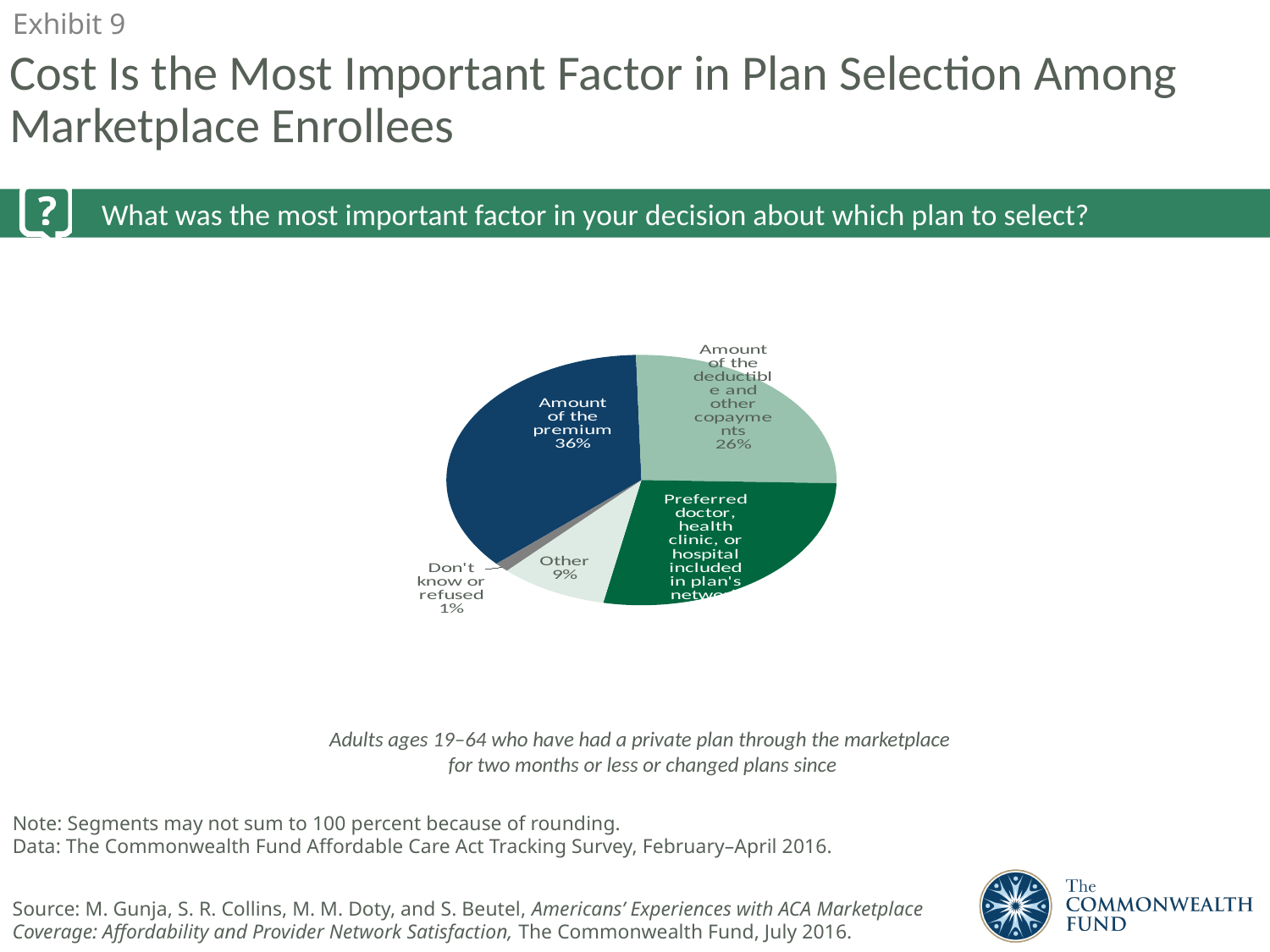
How many percentage points larger is the "Amount of the premium" slice than the "Amount of the deductible and other copayments" slice? 10 How many slices does the pie chart have? 5 Which factor has the largest slice of the pie? Amount of the premium What percentage of respondents answered "Other"? 9% What percentage of respondents said the amount of the premium was the most important factor? 36% What survey question is shown in the green banner above the chart? What was the most important factor in your decision about which plan to select? Which category has the smallest slice of the pie? Don't know or refused What percentage of respondents chose the amount of the deductible and other copayments? 26% What kind of chart is shown on the slide? pie chart What percentage of respondents answered "Don't know or refused"? 1% Which slice is larger: "Preferred doctor, health clinic, or hospital included in plan's network" or "Other"? Preferred doctor, health clinic, or hospital included in plan's network Which is larger: the share for "Amount of the premium" or the share for "Amount of the deductible and other copayments"? Amount of the premium